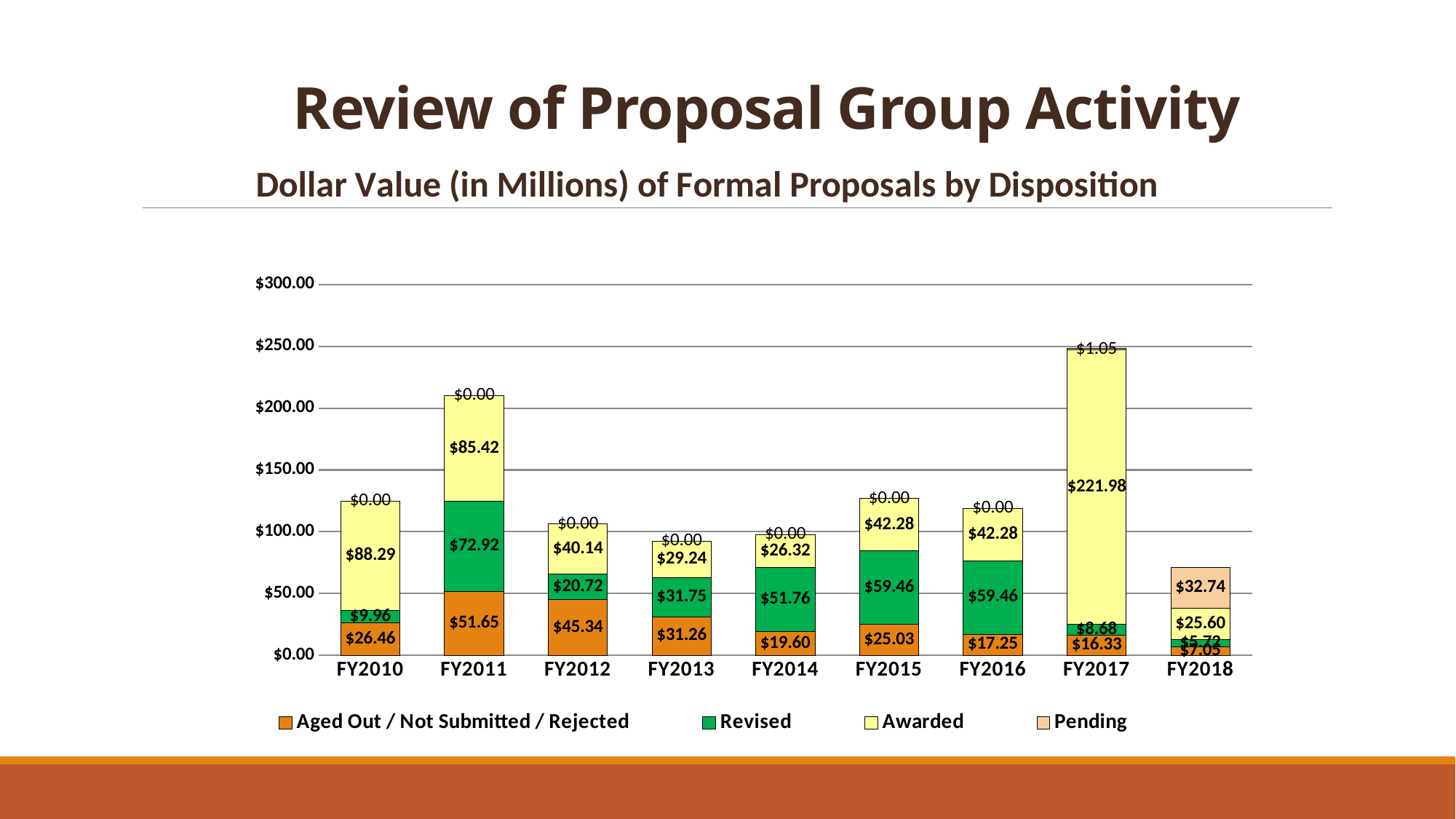
What is the Aged Out / Not Submitted / Rejected value for FY2011? $51.65 What is the difference between the Awarded values for FY2010 and FY2011? $2.87 Which fiscal year has the lowest Aged Out / Not Submitted / Rejected value? FY2018 Which is larger, the Revised value for FY2012 or the Revised value for FY2013? FY2013 What is the Pending value for FY2018? $32.74 How many fiscal years are shown on the x axis? 9 What is the Awarded value for FY2017? $221.98 What kind of chart is shown on the slide? Stacked bar chart Which fiscal year has the highest Awarded value? FY2017 What is the total of the stacked bar for FY2018? $71.11 What is the Revised value for FY2014? $51.76 How many series does the legend list? 4